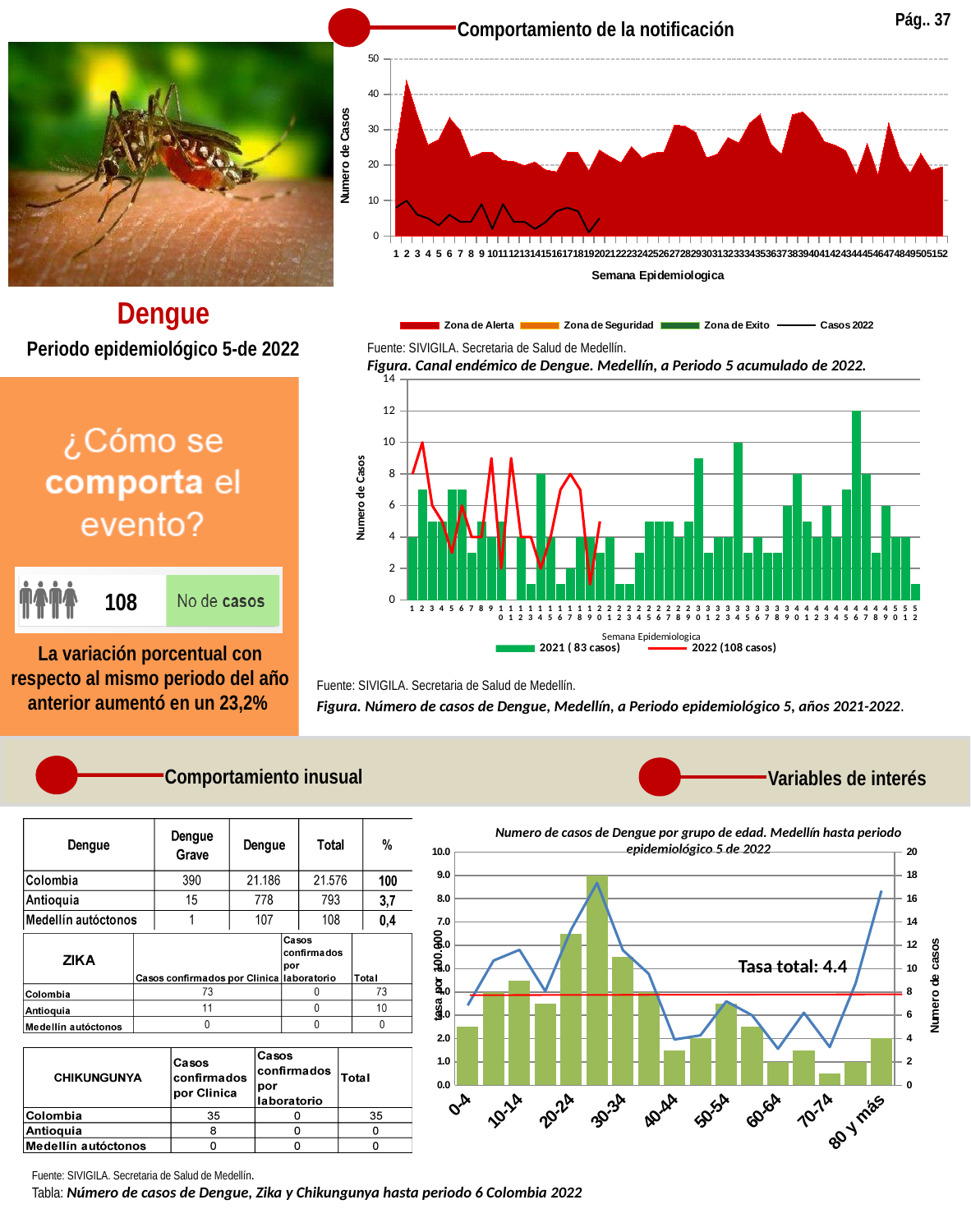
In the chart titled 'Numero de casos de Dengue por grupo de edad', which age group has the taller bar, 20-24 or 40-44? 20-24 In the chart titled 'Número de casos de Dengue, Medellín, a Periodo epidemiológico 5, años 2021-2022', what is the legend entry for the green bars? 2021 ( 83 casos) In the chart titled 'Número de casos de Dengue, Medellín, a Periodo epidemiológico 5, años 2021-2022', how many series does the legend list? 2 In the chart titled 'Número de casos de Dengue, Medellín, a Periodo epidemiológico 5, años 2021-2022', is the 2021 bar for week 35 greater or less than 8? less In the chart titled 'Número de casos de Dengue, Medellín, a Periodo epidemiológico 5, años 2021-2022', at which epidemiological week is the 2021 bar highest? 46 In the chart titled 'Número de casos de Dengue, Medellín, a Periodo epidemiológico 5, años 2021-2022', is the 2021 bar for week 46 greater or less than 10? greater In the chart titled 'Numero de casos de Dengue por grupo de edad', what kind of chart is used for the age-group values? bar chart with a line In the chart titled 'Canal endémico de Dengue', is the 'Casos 2022' line at week 10 greater or less than 20? less In the chart titled 'Canal endémico de Dengue', what is the label of the x axis? Semana Epidemiologica In the chart titled 'Numero de casos de Dengue por grupo de edad', what value is given for 'Tasa total'? 4.4 In the chart titled 'Canal endémico de Dengue. Medellín, a Periodo 5 acumulado de 2022', how many entries does the legend list? 4